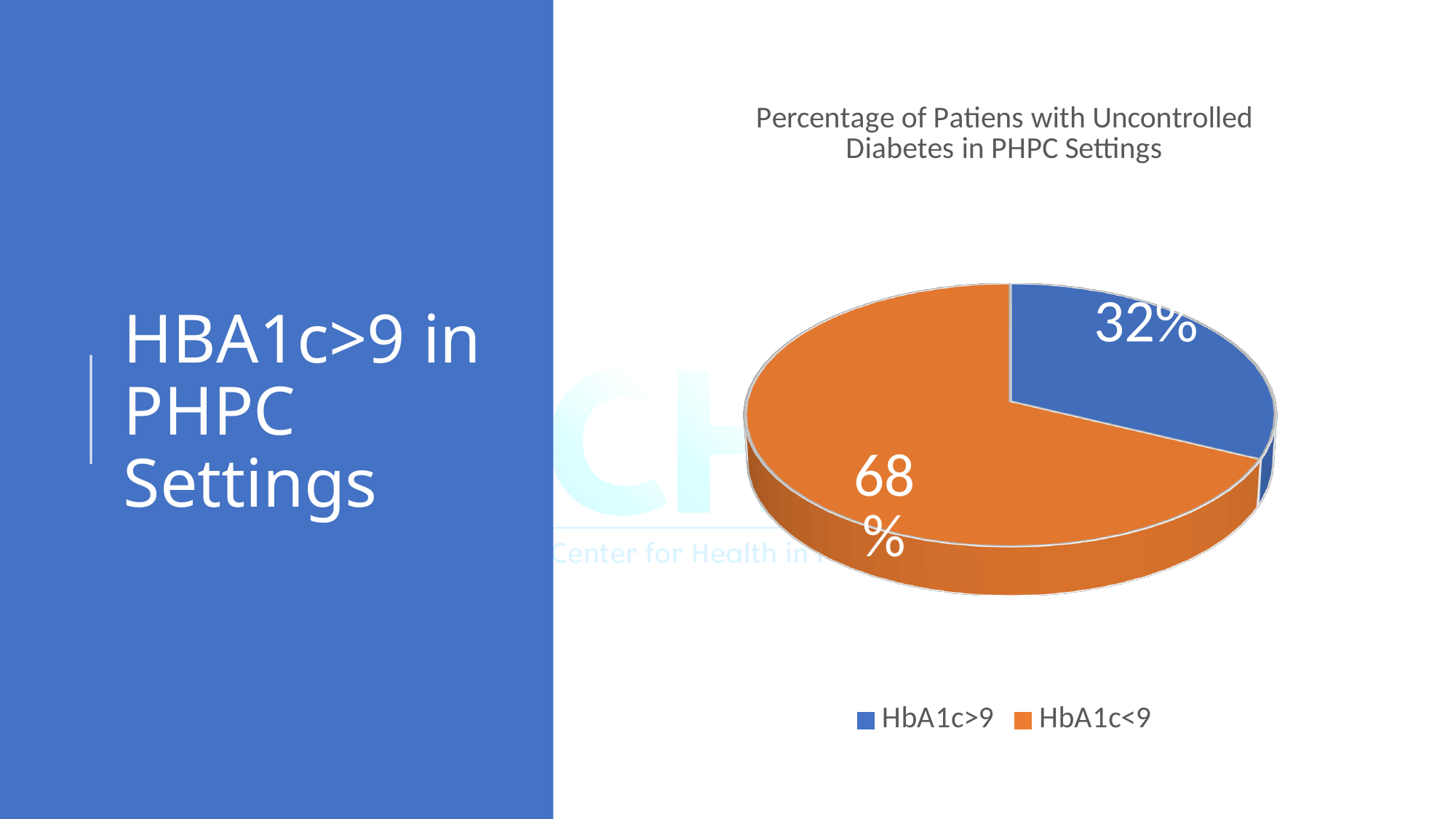
Which category has the smallest share of the pie? HbA1c>9 What is the difference in percentage points between the HbA1c<9 and HbA1c>9 slices? 36 What type of chart is shown on the slide? Pie chart What percentage of patients have HbA1c<9? 68% What colour is the HbA1c>9 slice? Blue How many entries does the legend list? 2 What percentage of patients have HbA1c>9? 32% What share of the pie does the HbA1c<9 slice represent? 68% What is the chart's title? Percentage of Patiens with Uncontrolled Diabetes in PHPC Settings Which category has the largest share of the pie? HbA1c<9 How many slices does the pie chart have? 2 Which is larger, the HbA1c>9 slice or the HbA1c<9 slice? HbA1c<9